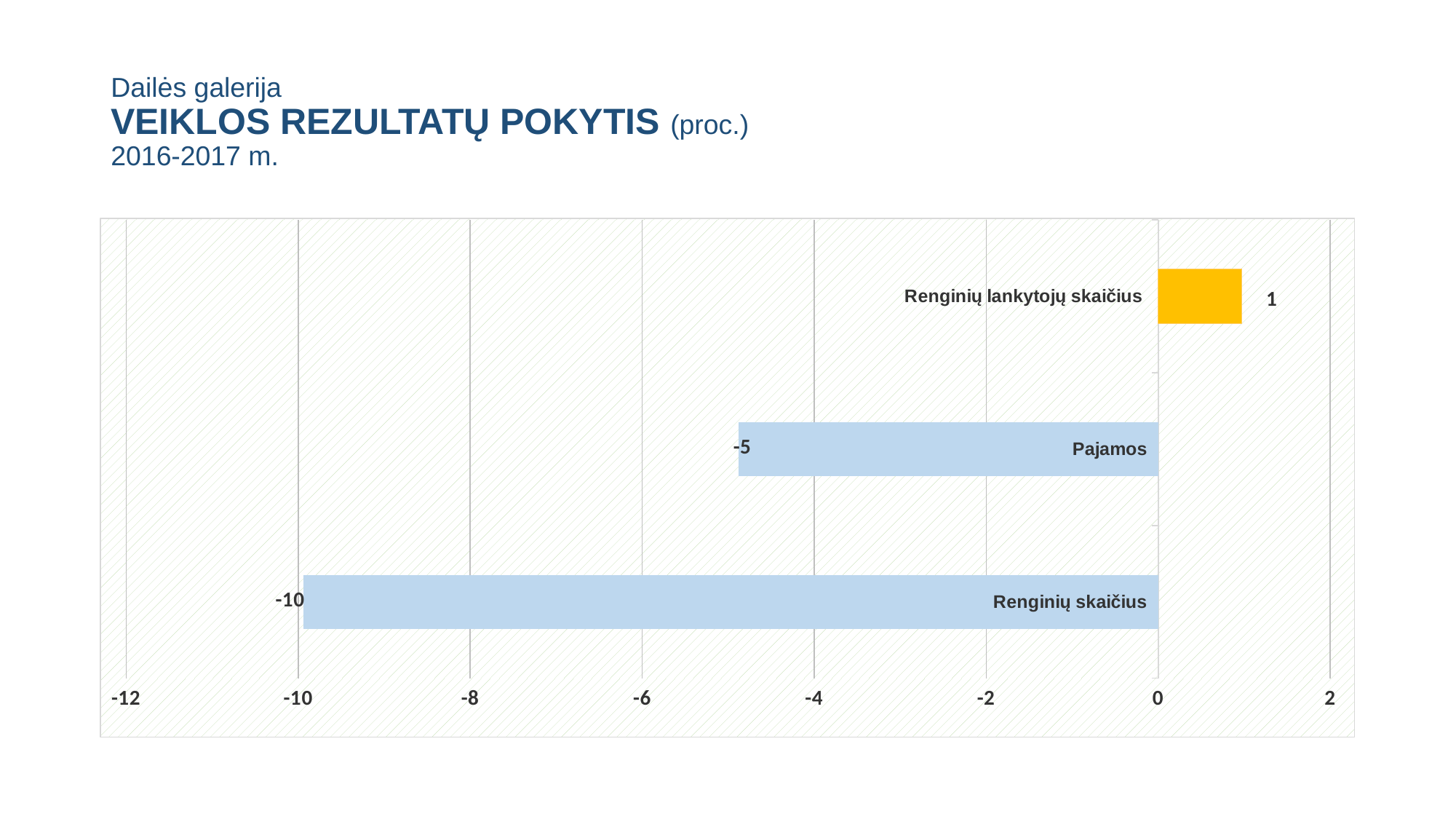
How many categories are shown in the chart? 3 Is the value for Renginių skaičius greater or less than -8? less Which is larger, the value for Pajamos or the value for Renginių skaičius? Pajamos What is the value for Renginių lankytojų skaičius? 1 What is the value for Pajamos? -5 What period does the chart title refer to? 2016-2017 m. Which category has the lowest value? Renginių skaičius What kind of chart is shown on the slide? Bar chart Which category's bar is coloured yellow? Renginių lankytojų skaičius What is the value for Renginių skaičius? -10 Which category has the highest value? Renginių lankytojų skaičius What is the difference between the values for Pajamos and Renginių skaičius? 5